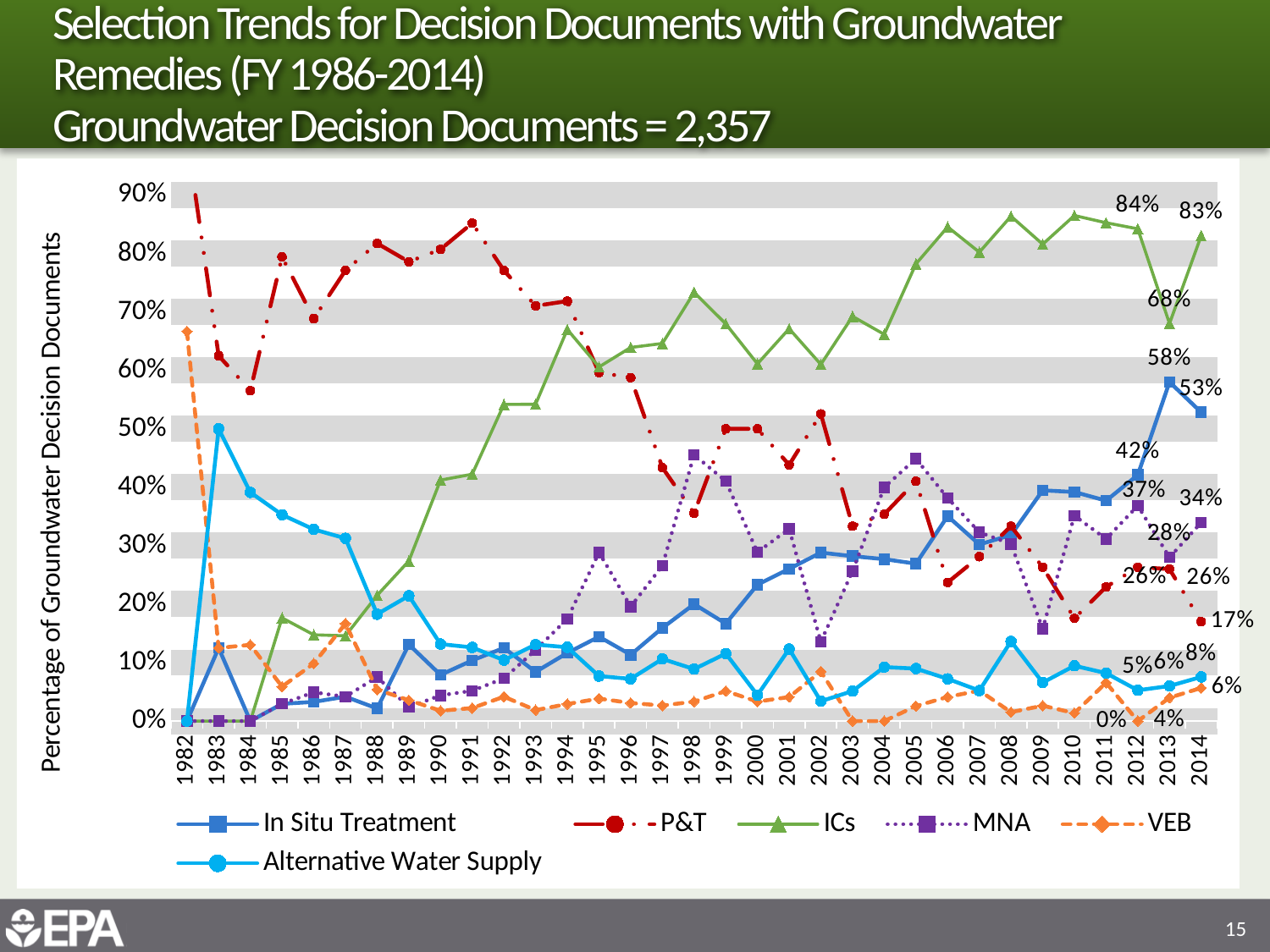
Which series has the highest value in 2014? ICs What is the value for ICs in 2014? 83% Does the P&T series generally rise or fall from 1991 to 2014? Fall Is the value for P&T in 1982 greater or less than 80%? greater How many series does the legend list? 6 What is the value for ICs in 2013? 68% In 2014, which is larger: the value for ICs or the value for P&T? ICs What is the value for MNA in 2014? 34% What kind of chart is shown on the slide? Line chart What is the value for P&T in 2014? 17% What is the difference between the ICs value and the In Situ Treatment value in 2014? 30 percentage points What is the value for In Situ Treatment in 2013? 58%